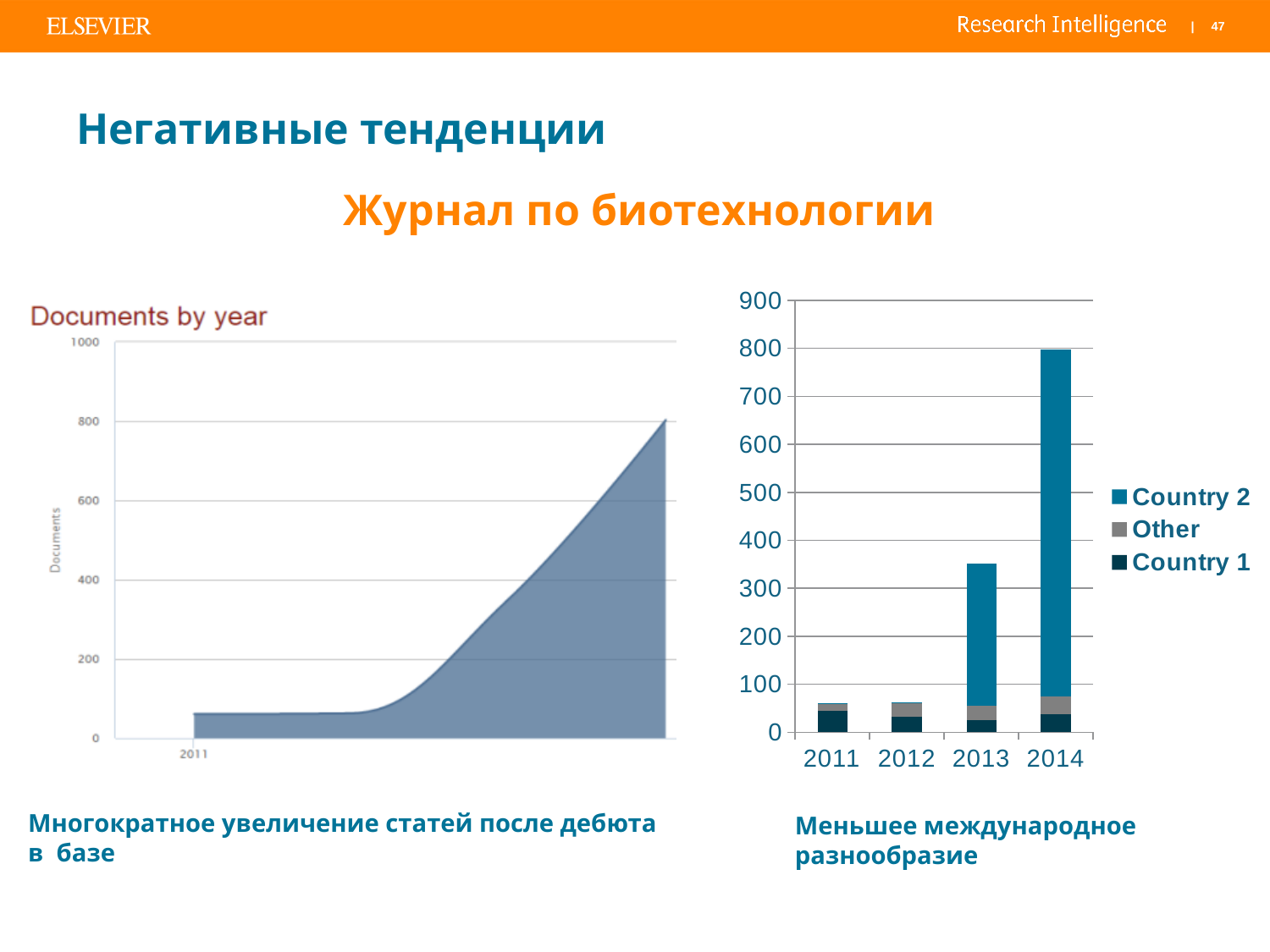
In the right chart, is the total for 2011 greater or less than 100? less What kind of chart is the left chart titled "Documents by year"? area chart In the right chart, which bar is taller, 2013 or 2014? 2014 In the left chart "Documents by year", do the values rise or fall from 2011 onward? rise In the left chart "Documents by year", is the value for 2011 greater or less than 200? less In the left chart "Documents by year", is the value at the end of the series greater or less than 600? greater What kind of chart is the right chart with the years 2011 to 2014? stacked bar chart How many years are shown on the x axis of the right chart? 4 In the right chart, which series makes up the largest part of the 2014 bar? Country 2 In the right chart, which year has the tallest bar? 2014 How many series does the legend of the right chart list? 3